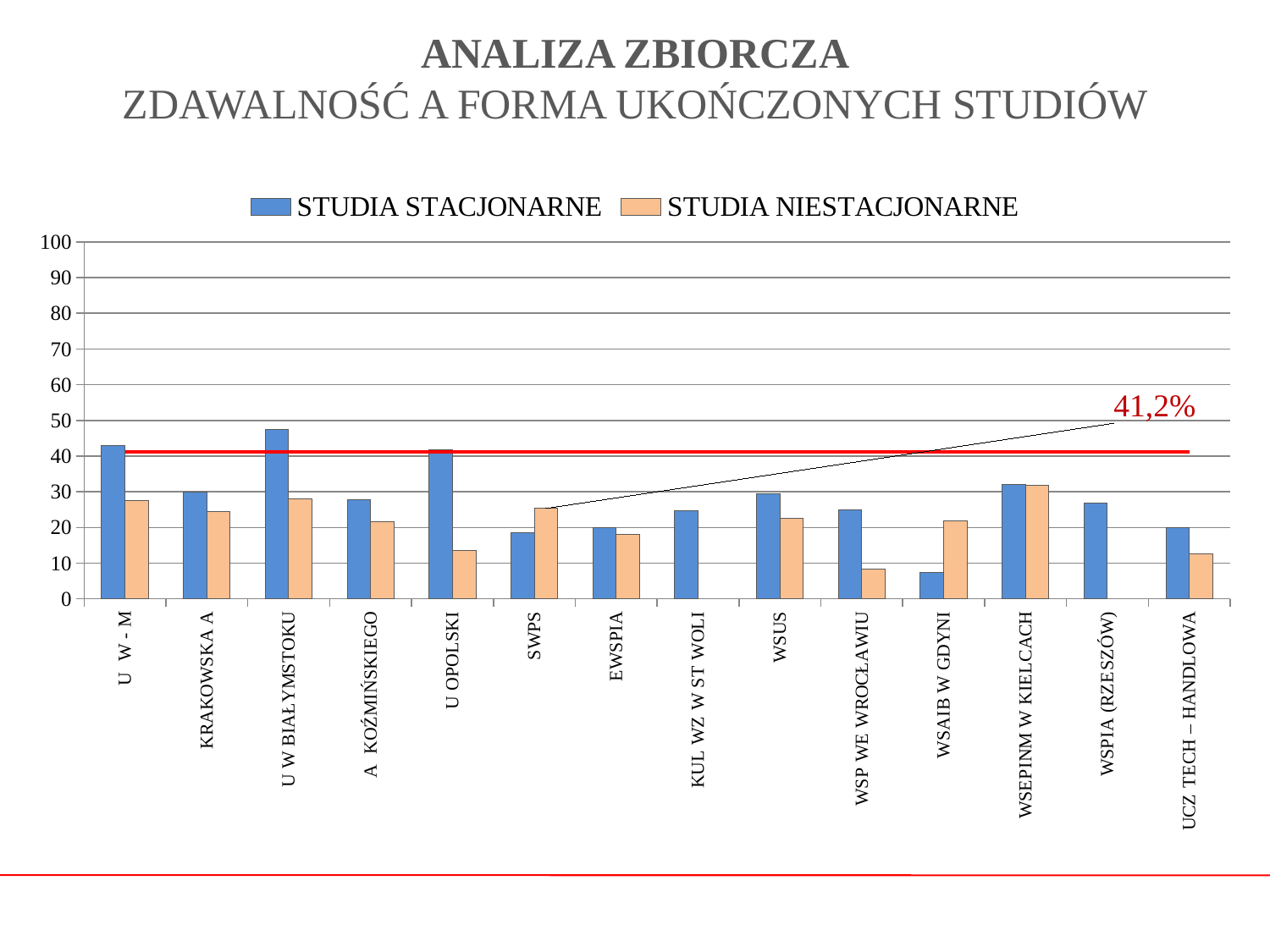
Which institution has the lowest value for STUDIA STACJONARNE? WSAIB W GDYNI Which institution has the highest value for STUDIA NIESTACJONARNE? WSEPINM W KIELCACH What value is labelled on the red horizontal reference line? 41,2% Is the STUDIA STACJONARNE value for U W - M greater or less than 40? greater Which institution has the highest value for STUDIA STACJONARNE? U W BIAŁYMSTOKU For U OPOLSKI, which is larger: STUDIA STACJONARNE or STUDIA NIESTACJONARNE? STUDIA STACJONARNE Is the STUDIA NIESTACJONARNE value for U OPOLSKI greater or less than 20? less For SWPS, which is larger: STUDIA STACJONARNE or STUDIA NIESTACJONARNE? STUDIA NIESTACJONARNE How many institutions (categories) are shown on the x axis? 14 What kind of chart is shown on the slide? bar chart Is the STUDIA NIESTACJONARNE value for WSP WE WROCŁAWIU greater or less than 10? less How many series does the legend list? 2